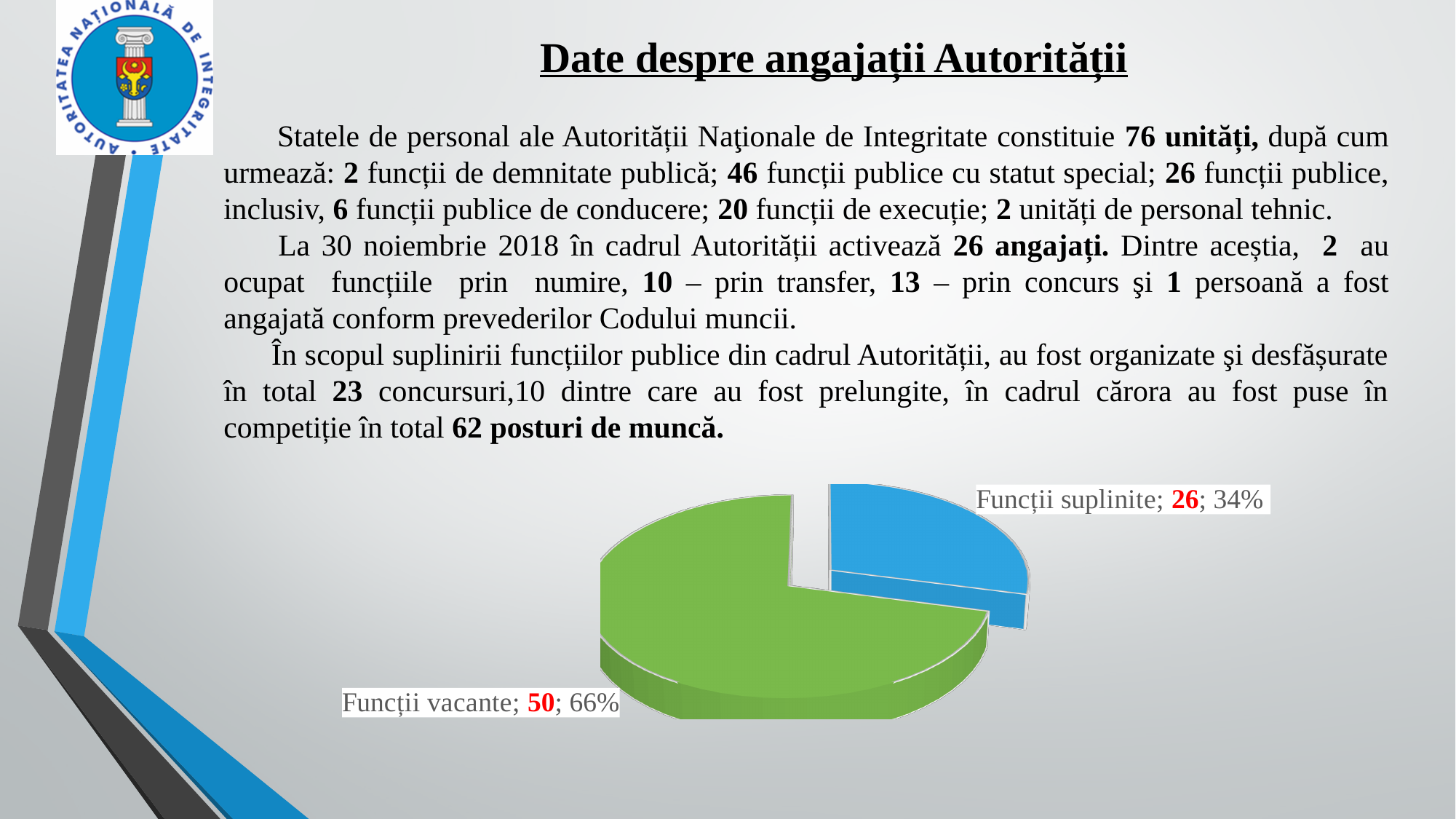
What is the total of the two slices in the pie chart? 76 What kind of chart is shown on the slide? pie chart Which slice of the pie chart is the largest? Funcții vacante What share of the pie does Funcții suplinite represent? 34% Which is larger, Funcții vacante or Funcții suplinite? Funcții vacante What is the value for Funcții suplinite in the pie chart? 26 How many slices does the pie chart have? 2 What colour is the Funcții suplinite slice in the pie chart? blue What share of the pie does Funcții vacante represent? 66% What is the value for Funcții vacante in the pie chart? 50 Which slice of the pie chart is the smallest? Funcții suplinite What is the difference between the values for Funcții vacante and Funcții suplinite? 24